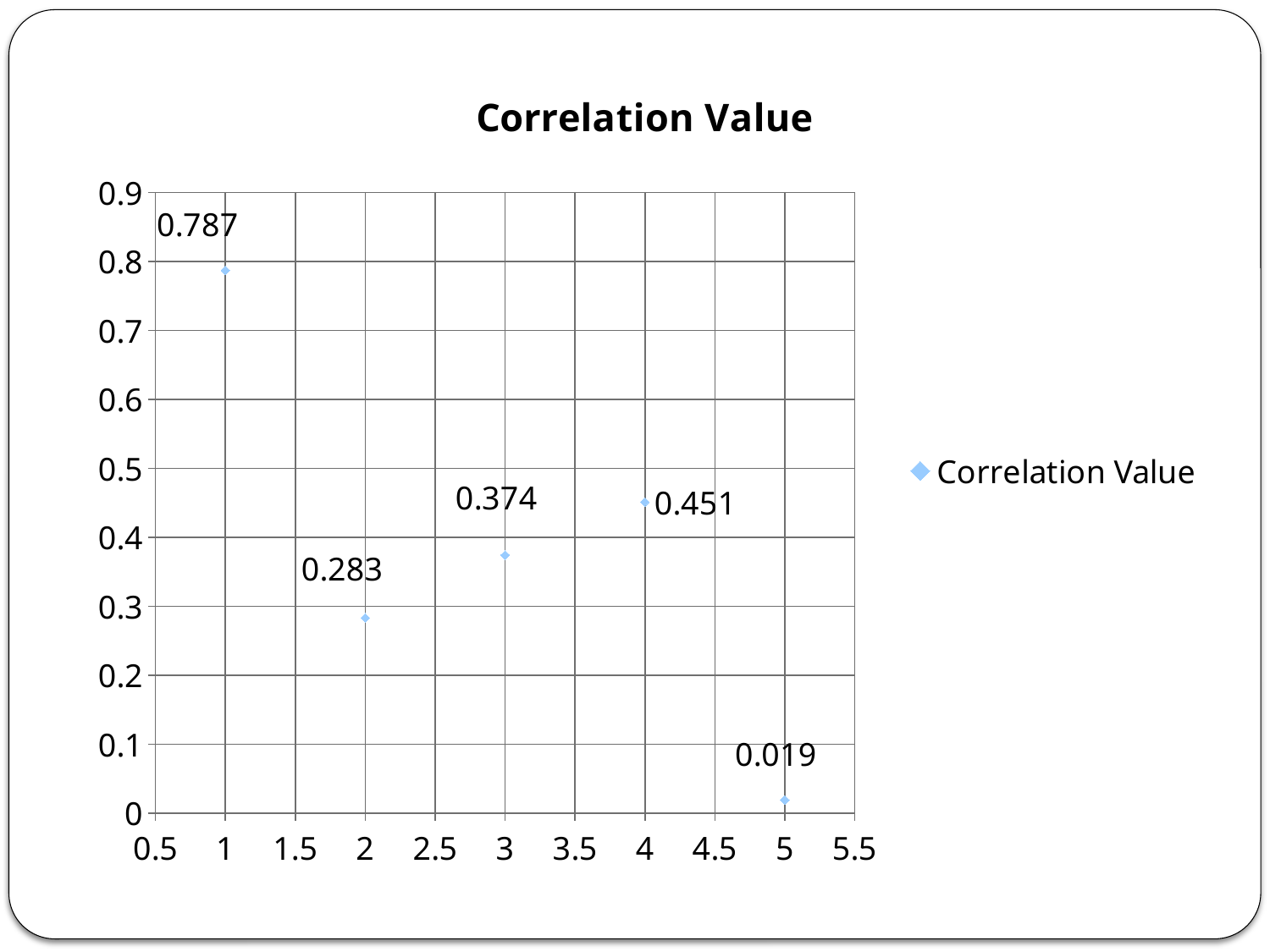
What is the Correlation Value at x = 1? 0.787 What is the title of the chart? Correlation Value What is the difference between the Correlation Value at x = 1 and at x = 5? 0.768 At which x value is the Correlation Value lowest? 5 How many data points are plotted on the chart? 5 What is the Correlation Value at x = 4? 0.451 What kind of chart is shown on the slide? Scatter chart At which x value is the Correlation Value highest? 1 Which is larger, the Correlation Value at x = 3 or at x = 4? x = 4 What is the Correlation Value at x = 5? 0.019 What is the Correlation Value at x = 3? 0.374 What is the Correlation Value at x = 2? 0.283